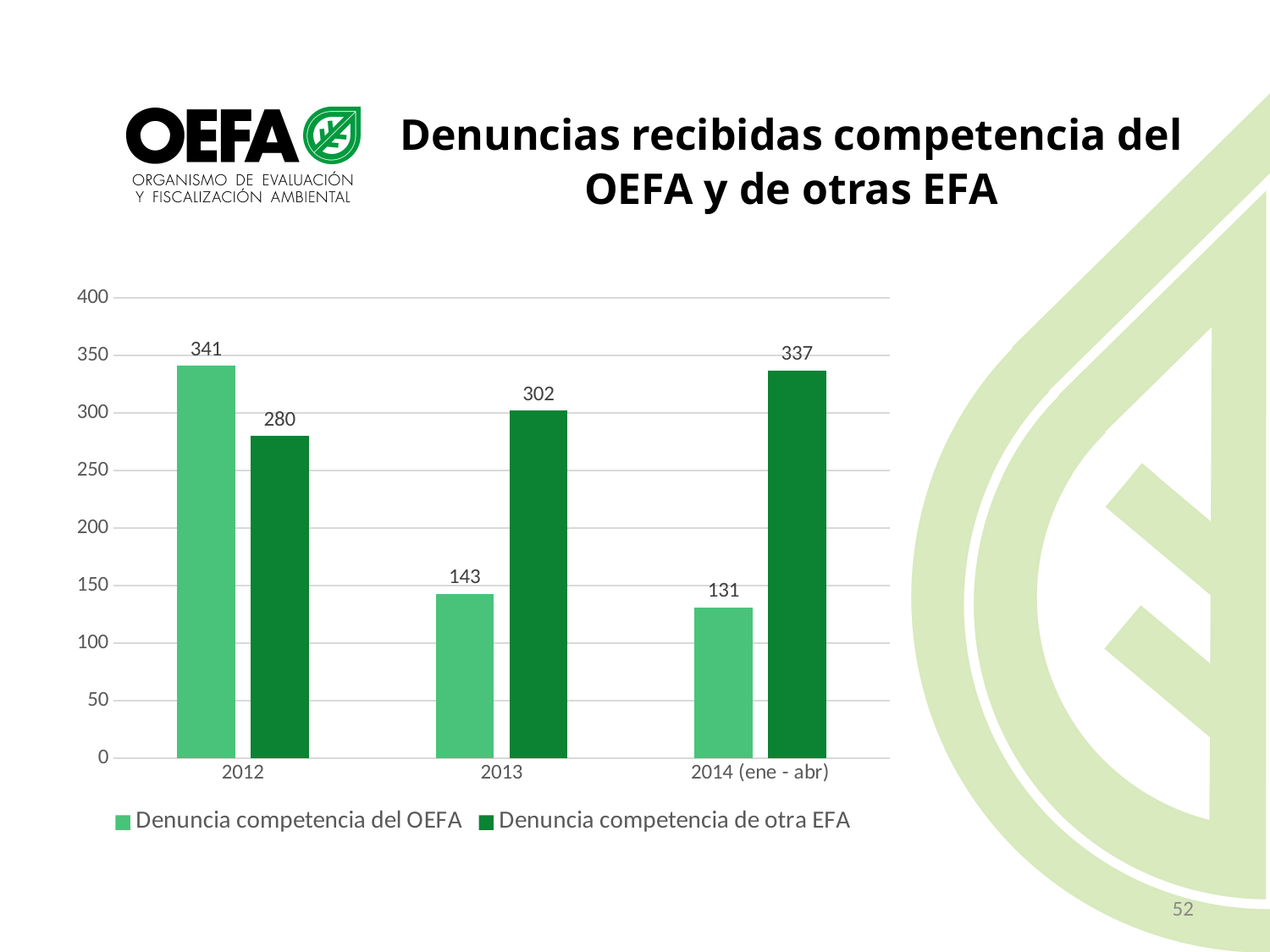
In which year is the value for 'Denuncia competencia del OEFA' lowest? 2014 (ene - abr) What is the value for 'Denuncia competencia del OEFA' in 2012? 341 What is the difference between 'Denuncia competencia del OEFA' and 'Denuncia competencia de otra EFA' in 2012? 61 Which series has the larger value in 2013, 'Denuncia competencia del OEFA' or 'Denuncia competencia de otra EFA'? Denuncia competencia de otra EFA How many series does the legend list? 2 What is the value for 'Denuncia competencia del OEFA' in 2014 (ene - abr)? 131 Does the value for 'Denuncia competencia del OEFA' rise or fall from 2012 to 2014 (ene - abr)? fall How many categories are shown on the x axis? 3 In which year is the value for 'Denuncia competencia de otra EFA' highest? 2014 (ene - abr) Is the value for 'Denuncia competencia de otra EFA' in 2012 greater or less than 250? greater What is the value for 'Denuncia competencia de otra EFA' in 2013? 302 What kind of chart is shown on the slide? bar chart